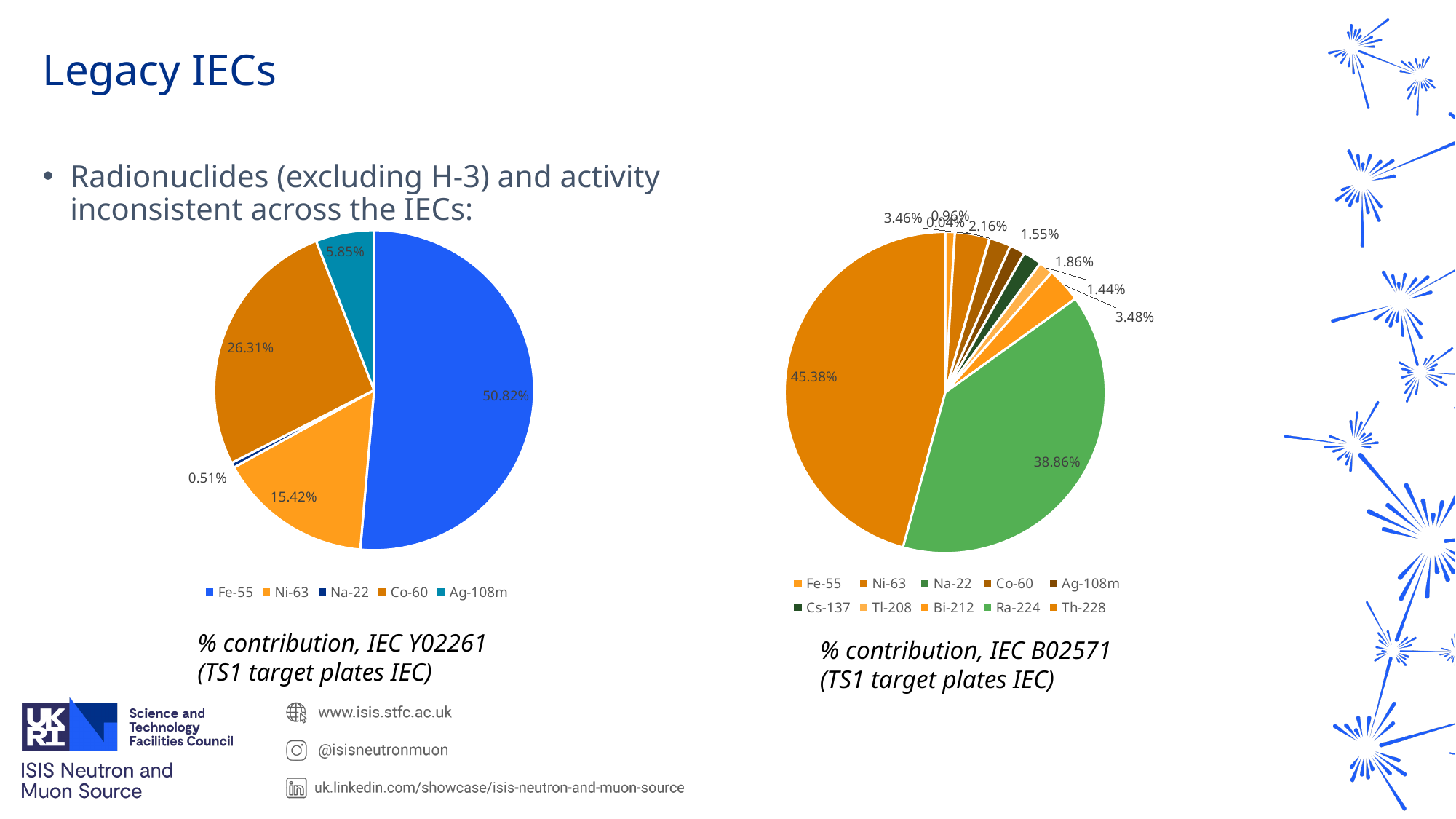
In the pie chart for IEC B02571 (right), what is the percentage contribution of Th-228? 45.38% In the pie chart for IEC B02571 (right), which radionuclide has the largest share? Th-228 How many radionuclides are listed in the legend of the IEC Y02261 pie chart (left)? 5 In the pie chart for IEC Y02261 (left), what is the percentage contribution of Co-60? 26.31% In the pie chart for IEC Y02261 (left), what is the percentage contribution of Fe-55? 50.82% In the pie chart for IEC Y02261 (left), what is the difference between the Co-60 and Ni-63 shares? 10.89% In the pie chart for IEC Y02261 (left), what is the percentage contribution of Na-22? 0.51% In the pie chart for IEC Y02261 (left), which radionuclide has the largest share? Fe-55 In the pie chart for IEC Y02261 (left), which radionuclide has the smallest share? Na-22 What type of chart is used on this slide to show the % contribution of radionuclides? Pie chart In the pie chart for IEC B02571 (right), what is the percentage contribution of Ra-224? 38.86% How many radionuclides are listed in the legend of the IEC B02571 pie chart (right)? 10